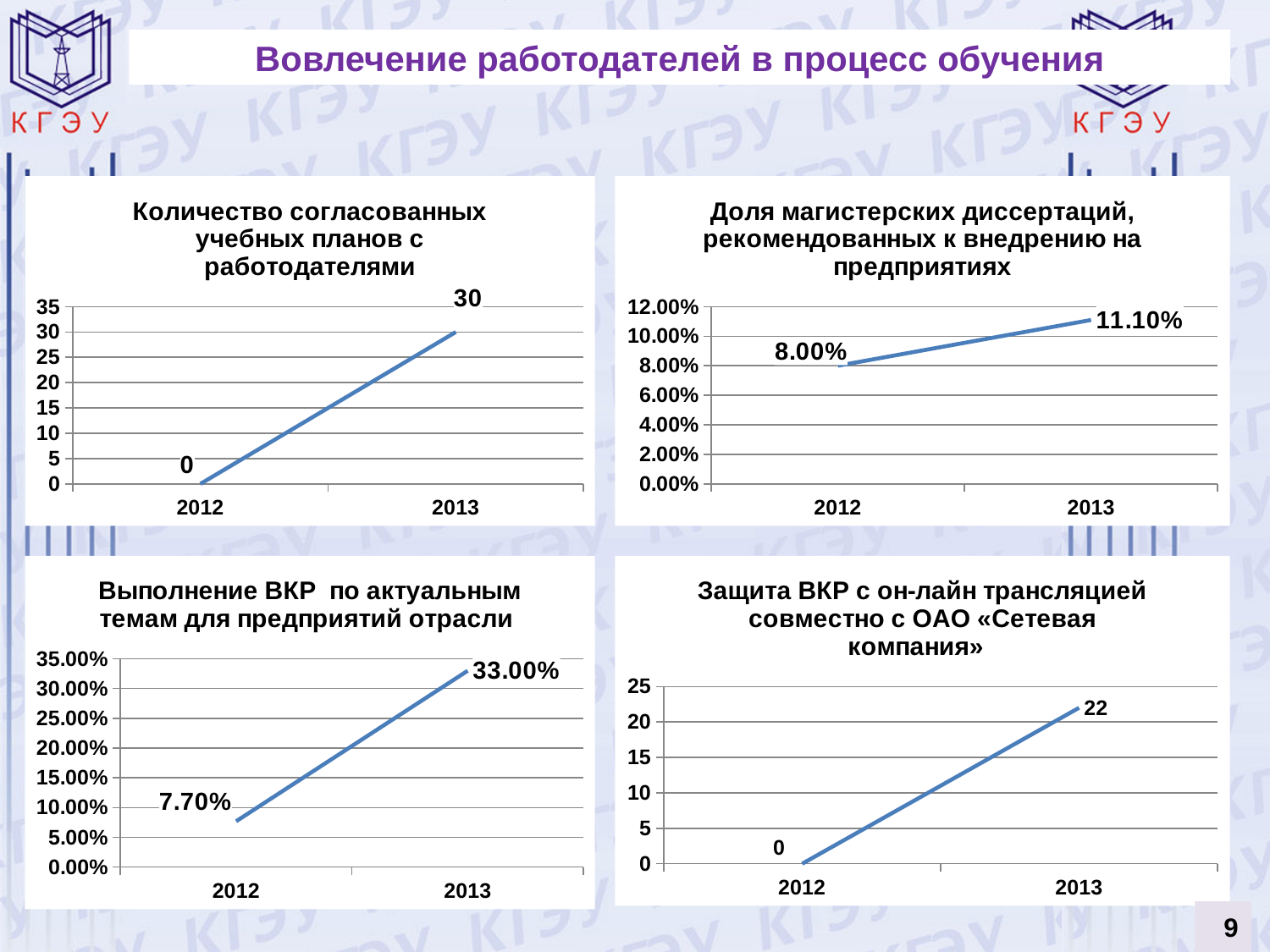
In the top-left chart (Количество согласованных учебных планов с работодателями), what is the value for 2013? 30 In the top-left chart (Количество согласованных учебных планов с работодателями), what is the value for 2012? 0 In the top-right chart (Доля магистерских диссертаций, рекомендованных к внедрению на предприятиях), what is the value for 2012? 8.00% In the bottom-right chart (Защита ВКР с он-лайн трансляцией совместно с ОАО «Сетевая компания»), which year has the higher value? 2013 In the bottom-left chart (Выполнение ВКР по актуальным темам для предприятий отрасли), by how many percentage points did the value increase from 2012 to 2013? 25.30% In the bottom-left chart (Выполнение ВКР по актуальным темам для предприятий отрасли), what is the value for 2012? 7.70% In the top-right chart (Доля магистерских диссертаций, рекомендованных к внедрению на предприятиях), what is the value for 2013? 11.10% What type of chart is the top-left chart (Количество согласованных учебных планов с работодателями)? line chart In the bottom-left chart (Выполнение ВКР по актуальным темам для предприятий отрасли), what is the value for 2013? 33.00% In the top-right chart (Доля магистерских диссертаций, рекомендованных к внедрению на предприятиях), do the values rise or fall from 2012 to 2013? rise In the bottom-right chart (Защита ВКР с он-лайн трансляцией совместно с ОАО «Сетевая компания»), what is the value for 2013? 22 How many data points are plotted in the bottom-right chart (Защита ВКР с он-лайн трансляцией совместно с ОАО «Сетевая компания»)? 2